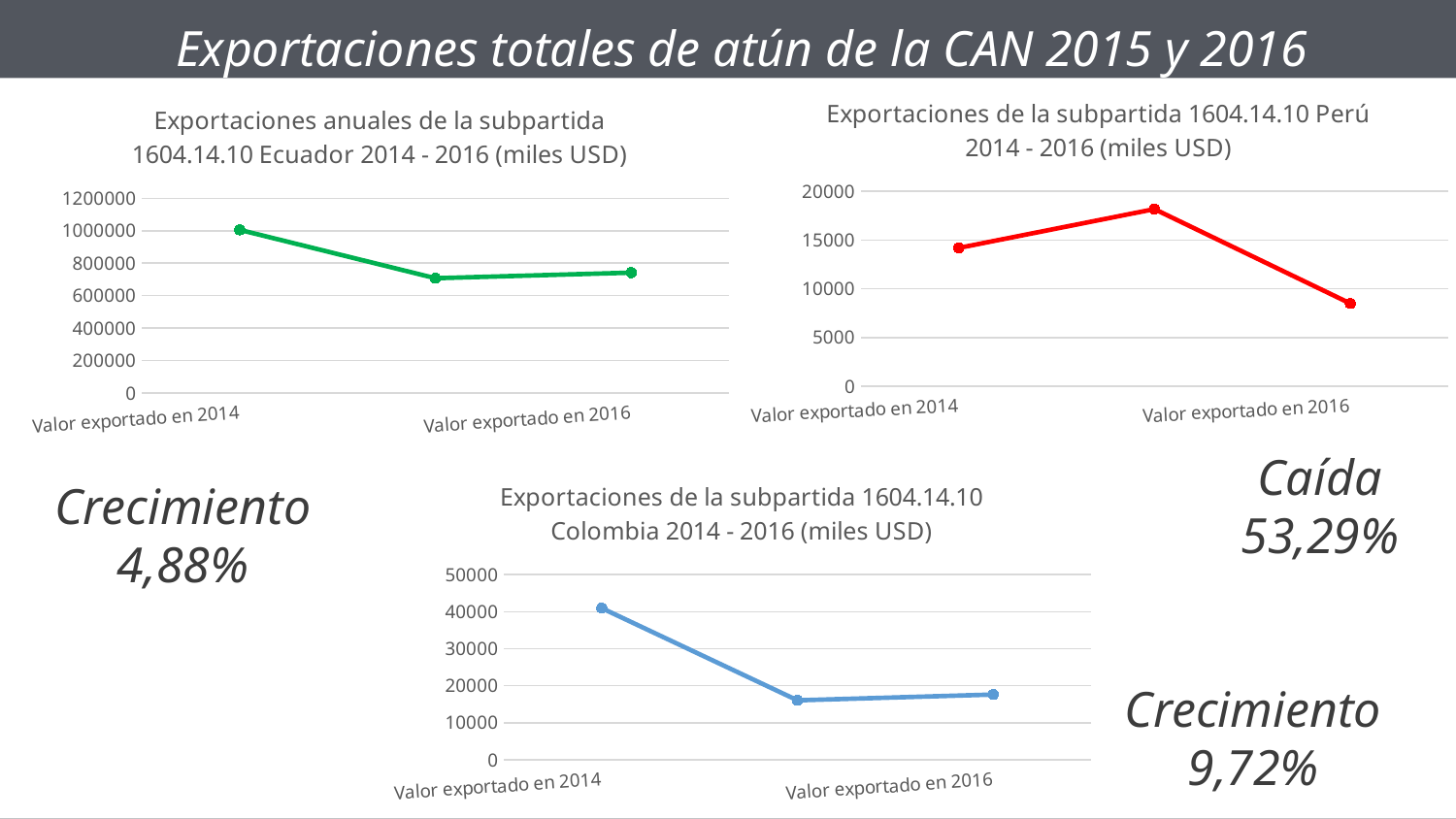
In the Colombia chart (bottom), is the value for 'Valor exportado en 2014' greater or less than 30000? greater What kind of chart is the 'Exportaciones anuales de la subpartida 1604.14.10 Ecuador 2014 - 2016 (miles USD)' chart? Line chart In the Colombia chart (bottom), is the value for 'Valor exportado en 2016' greater or less than 20000? less In the Ecuador chart, how many data points are plotted on the line? 3 In the Ecuador chart, which is larger, the value for 'Valor exportado en 2014' or 'Valor exportado en 2016'? Valor exportado en 2014 In the Perú chart (top right), is the value for 'Valor exportado en 2016' greater or less than 10000? less In the Colombia chart (bottom), does the line rise or fall from 'Valor exportado en 2014' to 'Valor exportado en 2016'? Fall In the Perú chart (top right), what colour is the plotted line? Red In the Perú chart (top right), which is larger, the value for 'Valor exportado en 2014' or 'Valor exportado en 2016'? Valor exportado en 2014 How many charts are shown on the slide? 3